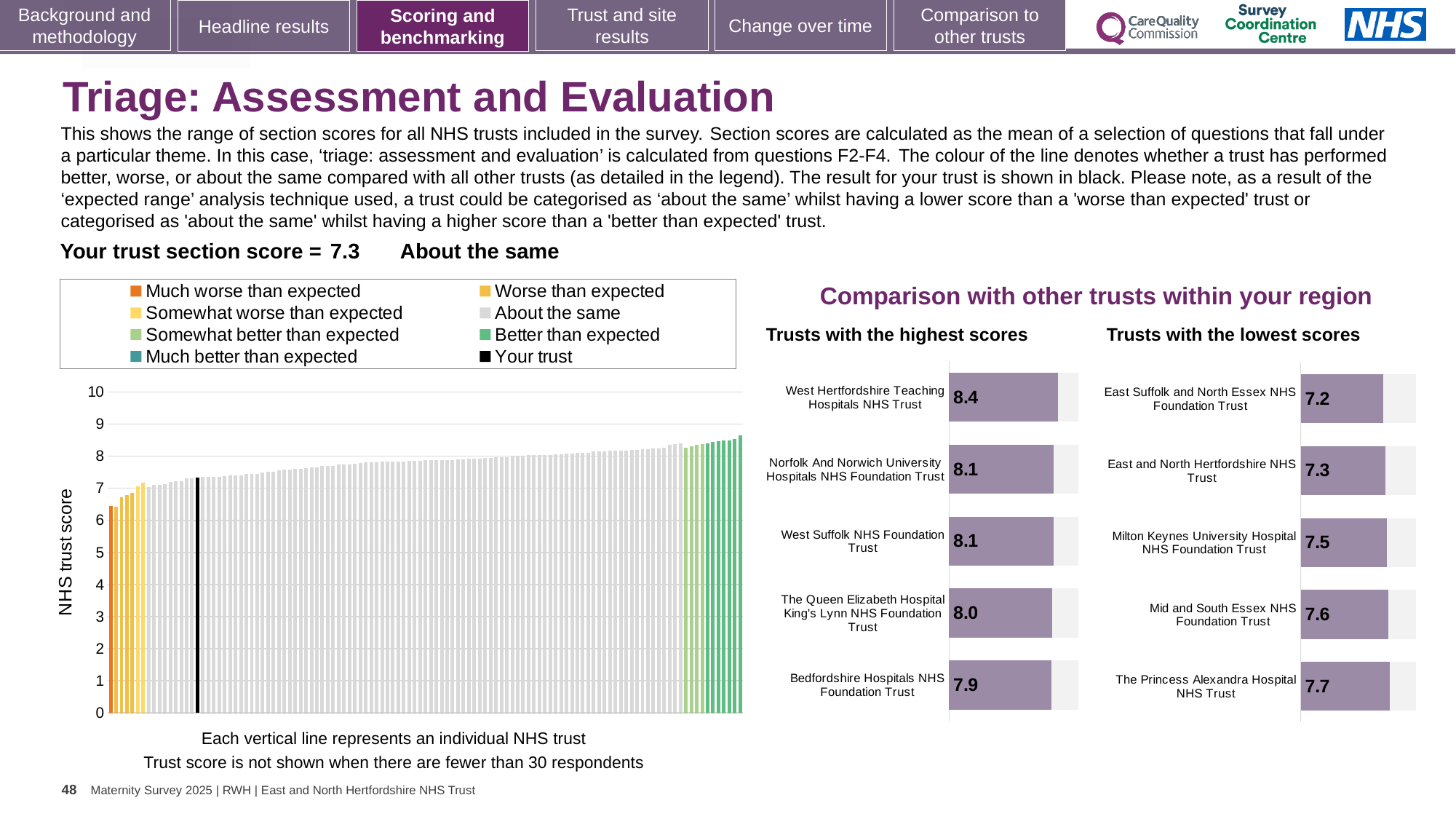
In the 'Trusts with the highest scores' chart, which trust has the highest score? West Hertfordshire Teaching Hospitals NHS Trust In the 'Trusts with the lowest scores' chart, what is the difference between the scores of The Princess Alexandra Hospital NHS Trust and East Suffolk and North Essex NHS Foundation Trust? 0.5 In the 'Trusts with the lowest scores' chart, which trust has the lowest score? East Suffolk and North Essex NHS Foundation Trust In the 'Trusts with the lowest scores' chart, which has the higher score: Mid and South Essex NHS Foundation Trust or East and North Hertfordshire NHS Trust? Mid and South Essex NHS Foundation Trust What kind of chart is the 'NHS trust score' chart on the left of the slide? bar chart In the 'Trusts with the highest scores' chart, what is the score for West Hertfordshire Teaching Hospitals NHS Trust? 8.4 How many trusts are shown in the 'Trusts with the highest scores' chart? 5 In the 'NHS trust score' chart on the left, do the values rise or fall from left to right? rise In the 'NHS trust score' chart on the left, what is the section score for your trust (the black bar)? 7.3 How many entries does the legend above the 'NHS trust score' chart list? 8 In the 'Trusts with the highest scores' chart, what is the difference between the scores of West Hertfordshire Teaching Hospitals NHS Trust and Bedfordshire Hospitals NHS Foundation Trust? 0.5 In the 'Trusts with the lowest scores' chart, what is the score for Milton Keynes University Hospital NHS Foundation Trust? 7.5